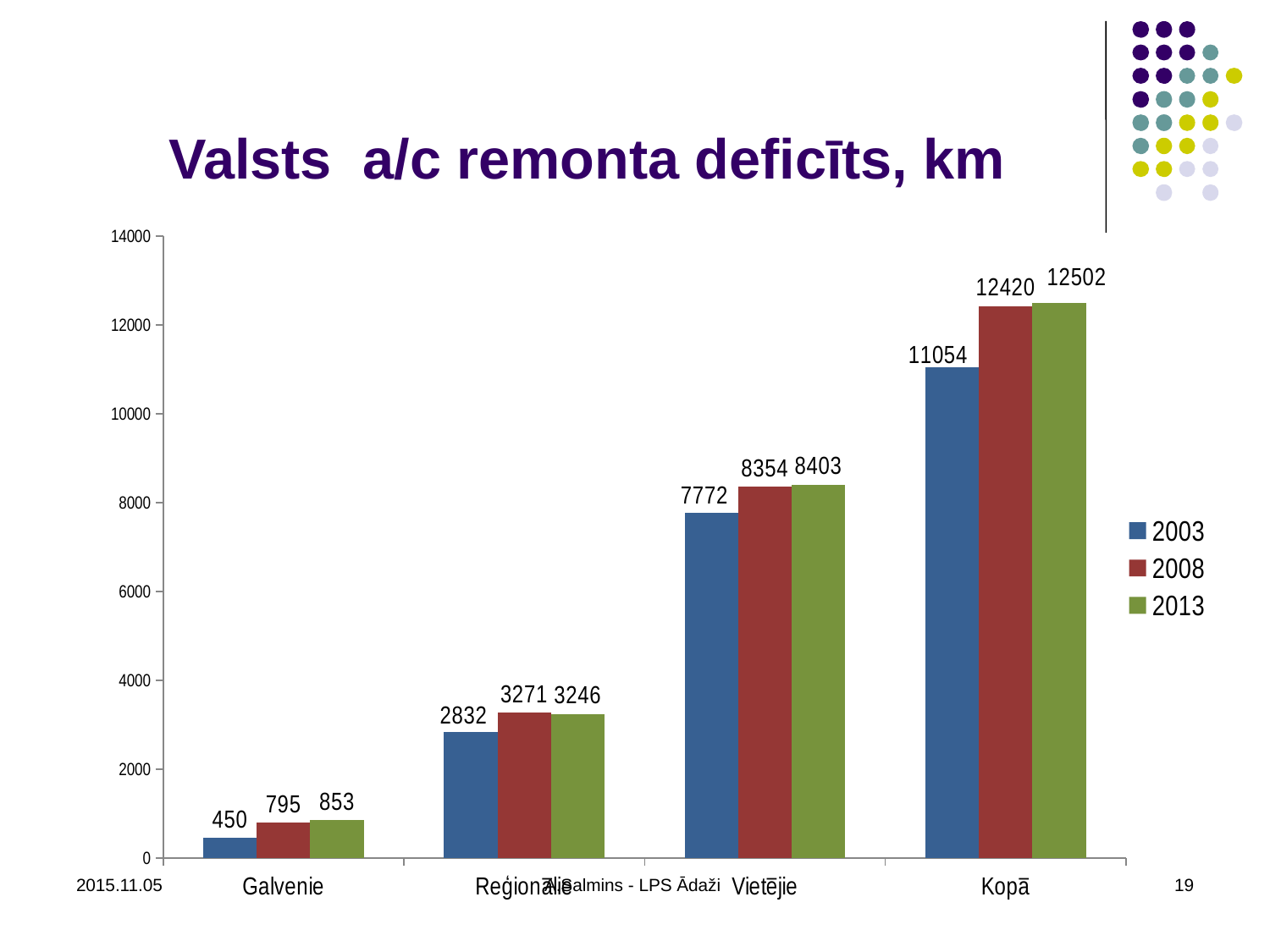
What is the value for Galvenie in 2003? 450 Which category has the highest value in 2013? Kopā What is the value for Kopā in 2013? 12502 Which category has the lowest value in 2008? Galvenie What is the title of the chart? Valsts a/c remonta deficīts, km What is the difference between the 2013 and 2003 values for Kopā? 1448 What is the difference between the 2008 and 2003 values for Galvenie? 345 How many series does the legend list? 3 What kind of chart is shown on the slide? bar chart Which is larger for Vietējie, the 2003 value or the 2013 value? 2013 How many categories are shown on the x axis? 4 What is the value for Vietējie in 2008? 8354